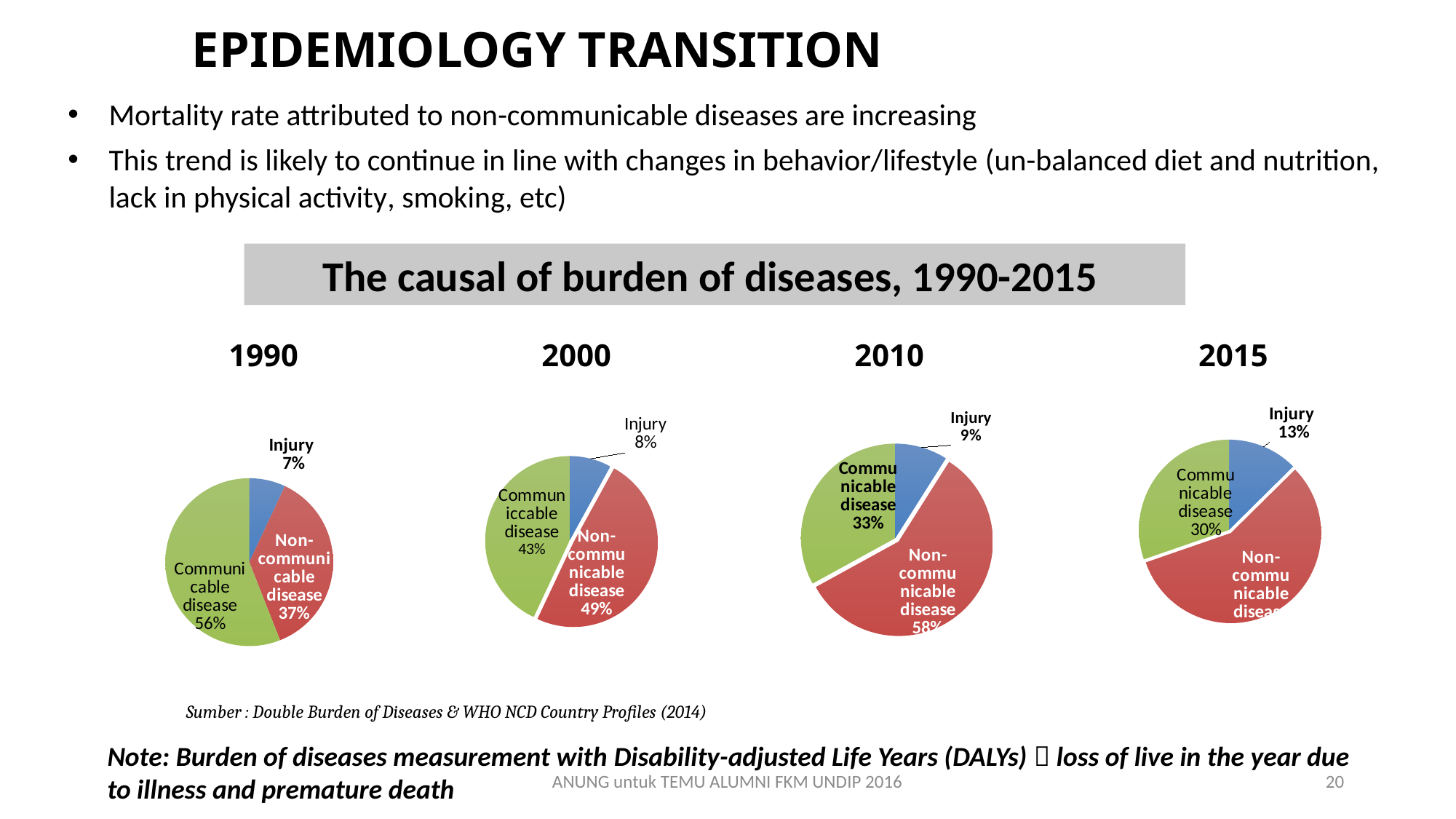
In the 2015 pie chart, what share is attributed to communicable disease? 30% In the 2015 pie chart, what share is attributed to injury? 13% In the 2000 pie chart, which is larger: the communicable disease share or the non-communicable disease share? Non-communicable disease In the 2010 pie chart, what share is attributed to non-communicable disease? 58% In the 1990 pie chart, which category has the largest share? Communicable disease In the 2010 pie chart, which category has the smallest share? Injury How many pie charts are shown on the slide? 4 In the 2000 pie chart, what is the difference between the non-communicable disease share and the communicable disease share? 6% In the 2000 pie chart, what share is attributed to injury? 8% In the 1990 pie chart, what share is attributed to communicable disease? 56% What kind of chart is used to show the causal of burden of diseases for each year? Pie chart In the 1990 pie chart, what share is attributed to non-communicable disease? 37%